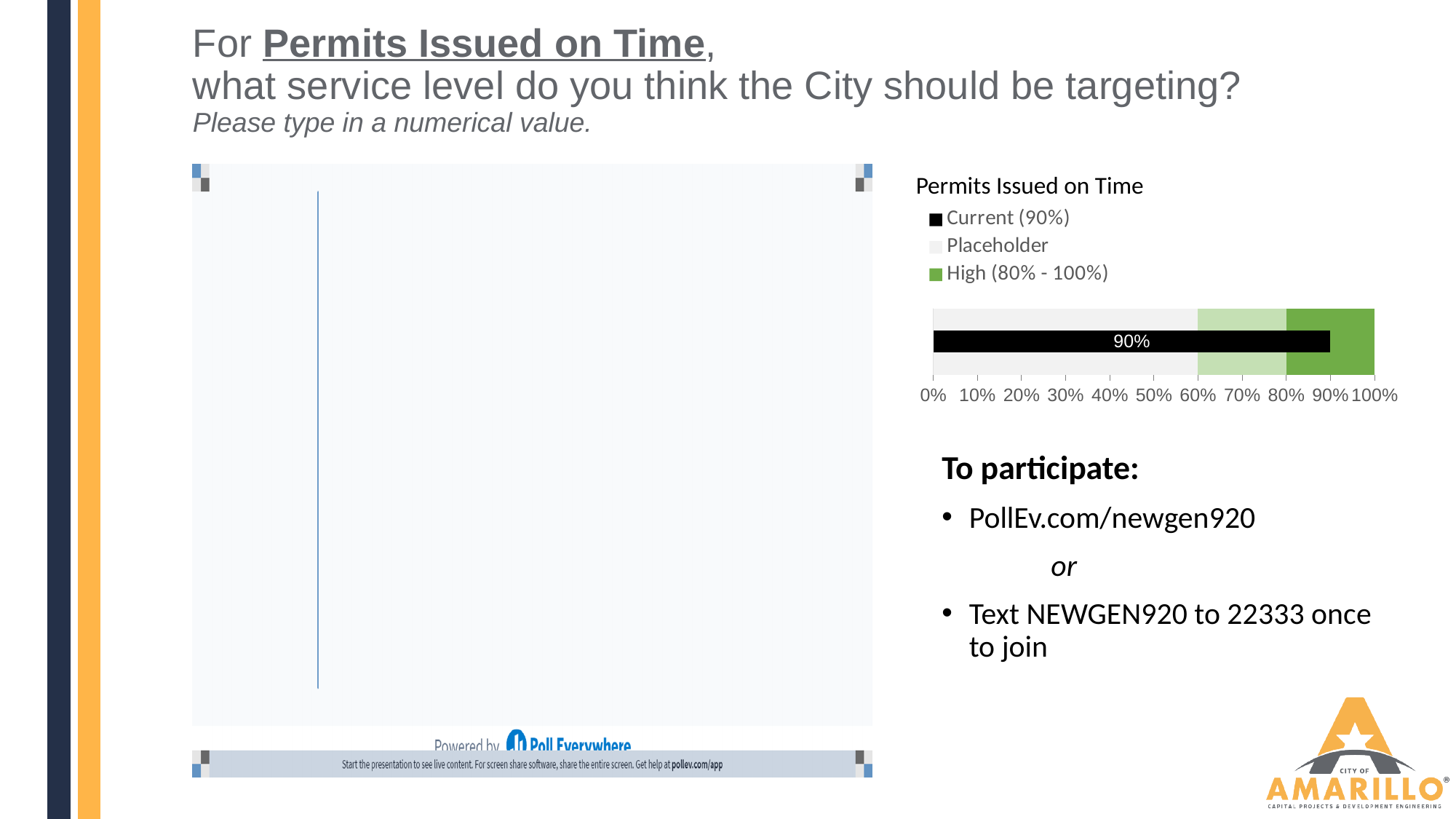
What is the title of the chart on the slide? Permits Issued on Time In the "Permits Issued on Time" chart, what is the lowest value shown on the horizontal axis? 0% How many series does the legend of the "Permits Issued on Time" chart list? 3 In the "Permits Issued on Time" chart, is the value of the Current bar greater or less than 100%? less In the "Permits Issued on Time" chart, what value is printed on the black Current bar? 90% In the "Permits Issued on Time" chart, is the value of the Current bar greater or less than 80%? greater In the "Permits Issued on Time" chart, what is the first legend entry? Current (90%) In the "Permits Issued on Time" chart, what range does the legend give for the High series? 80% - 100% In the "Permits Issued on Time" chart, what is the highest value shown on the horizontal axis? 100% What type of chart is shown under the title "Permits Issued on Time"? bar chart